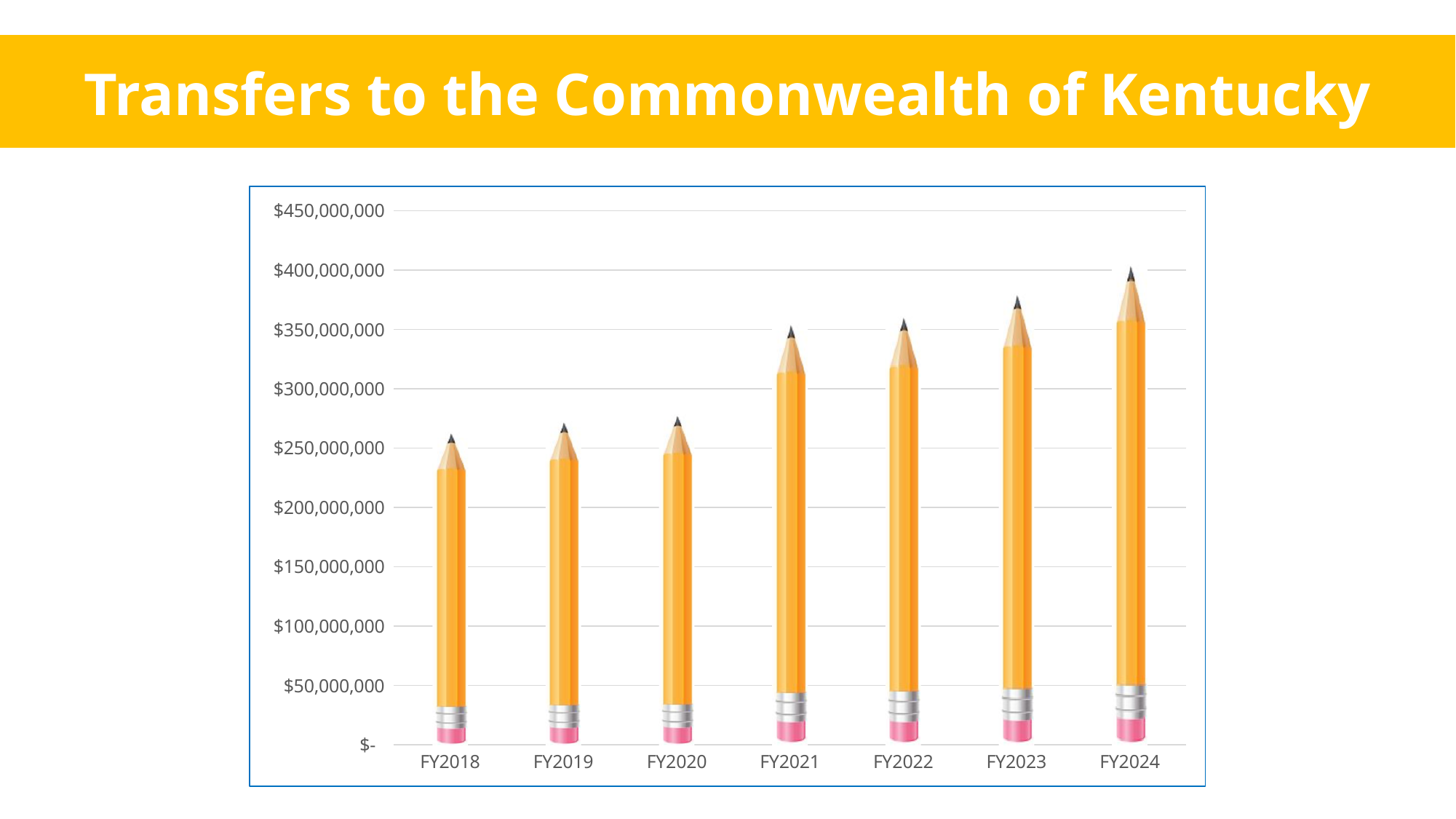
Is the value for FY2021 greater or less than $300,000,000? greater Which fiscal year has the lowest transfer value? FY2018 Which fiscal year has the highest transfer value? FY2024 Is the value for FY2024 greater or less than $350,000,000? greater What is the title of the chart? Transfers to the Commonwealth of Kentucky How many fiscal years are plotted on the chart? 7 Is the value for FY2018 greater or less than $300,000,000? less What shape are the bars drawn as on the chart? pencils Which is larger, the value for FY2019 or the value for FY2022? FY2022 Do the transfer values generally rise or fall from FY2018 to FY2024? rise What kind of chart is shown on the slide? bar chart